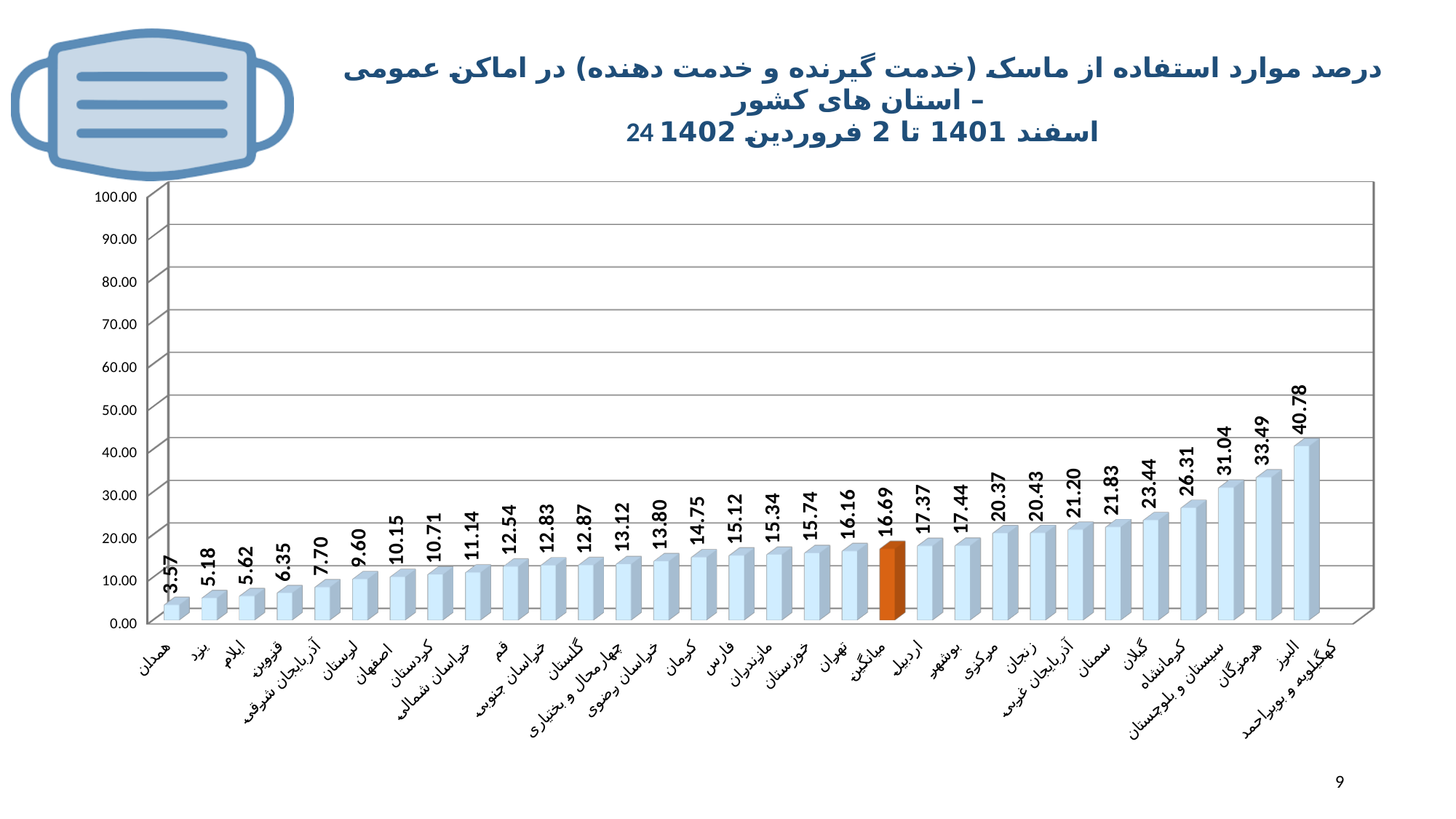
What is the difference between the values for قزوین and ایلام? 0.73 Do the values rise or fall from left to right along the x axis? rise What is the difference between the values for یزد and همدان? 1.61 Which is larger, the value for ایلام or the value for قزوین? قزوین What is the value of the orange bar labelled میانگین? 16.69 Which category is drawn in orange instead of light blue? میانگین What is the value for یزد? 5.18 What kind of chart is shown on the slide? bar chart Which category has the lowest value? همدان What is the value for همدان? 3.57 What is the value for لرستان? 9.60 What is the highest value shown on the chart? 40.78